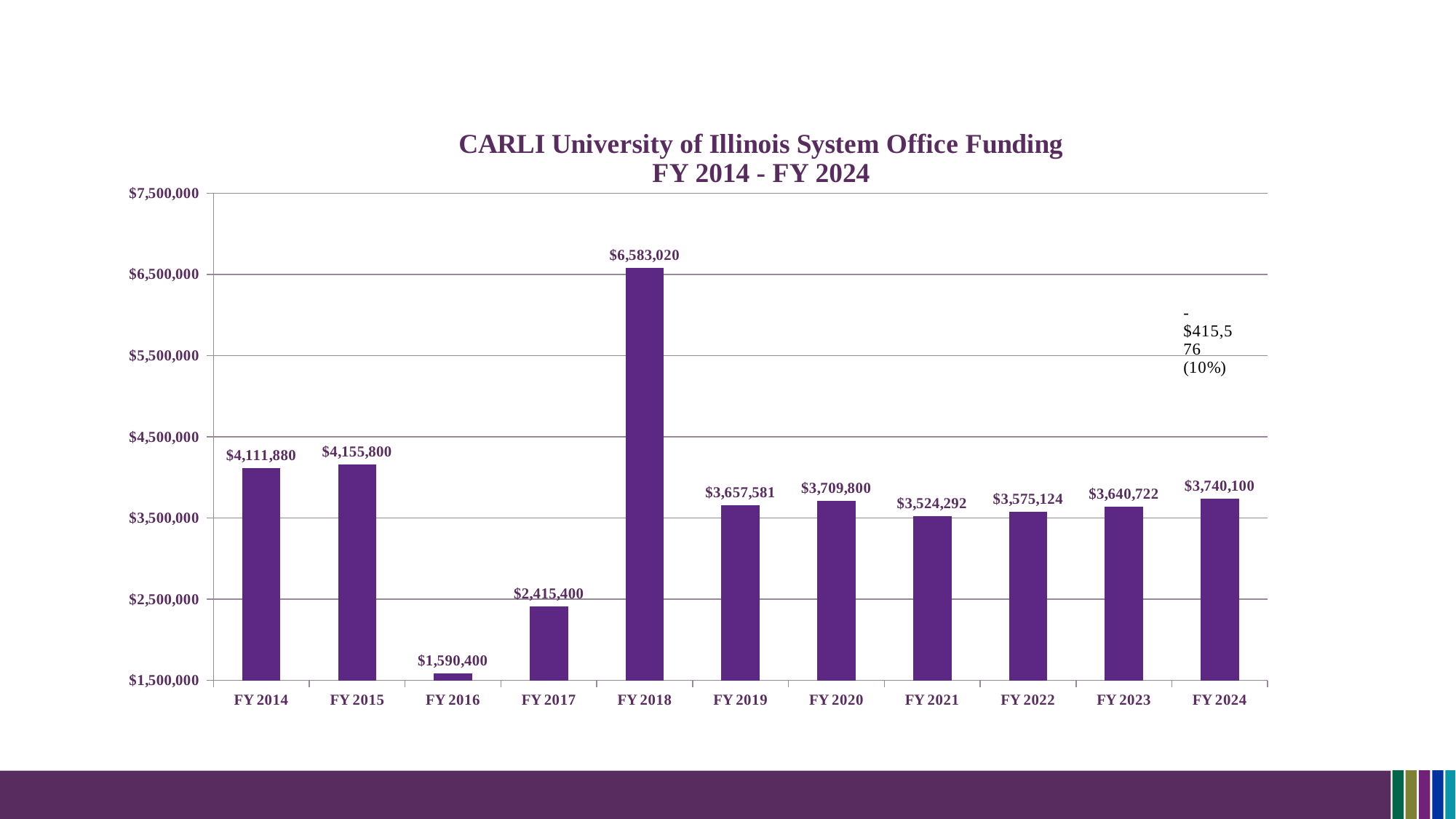
Which fiscal year has the highest funding? FY 2018 Which fiscal year has the lowest funding? FY 2016 Is the value for FY 2017 greater or less than $2,500,000? less What is the funding value for FY 2018? $6,583,020 What is the difference between the FY 2024 and FY 2023 funding values? $99,378 Do the funding values rise or fall from FY 2021 to FY 2024? Rise What is the funding value for FY 2021? $3,524,292 What is the difference between the FY 2018 and FY 2016 funding values? $4,992,620 What is the funding value for FY 2024? $3,740,100 Which is larger, the funding for FY 2014 or FY 2015? FY 2015 How many fiscal years are shown on the chart? 11 What kind of chart is shown on the slide? Bar chart